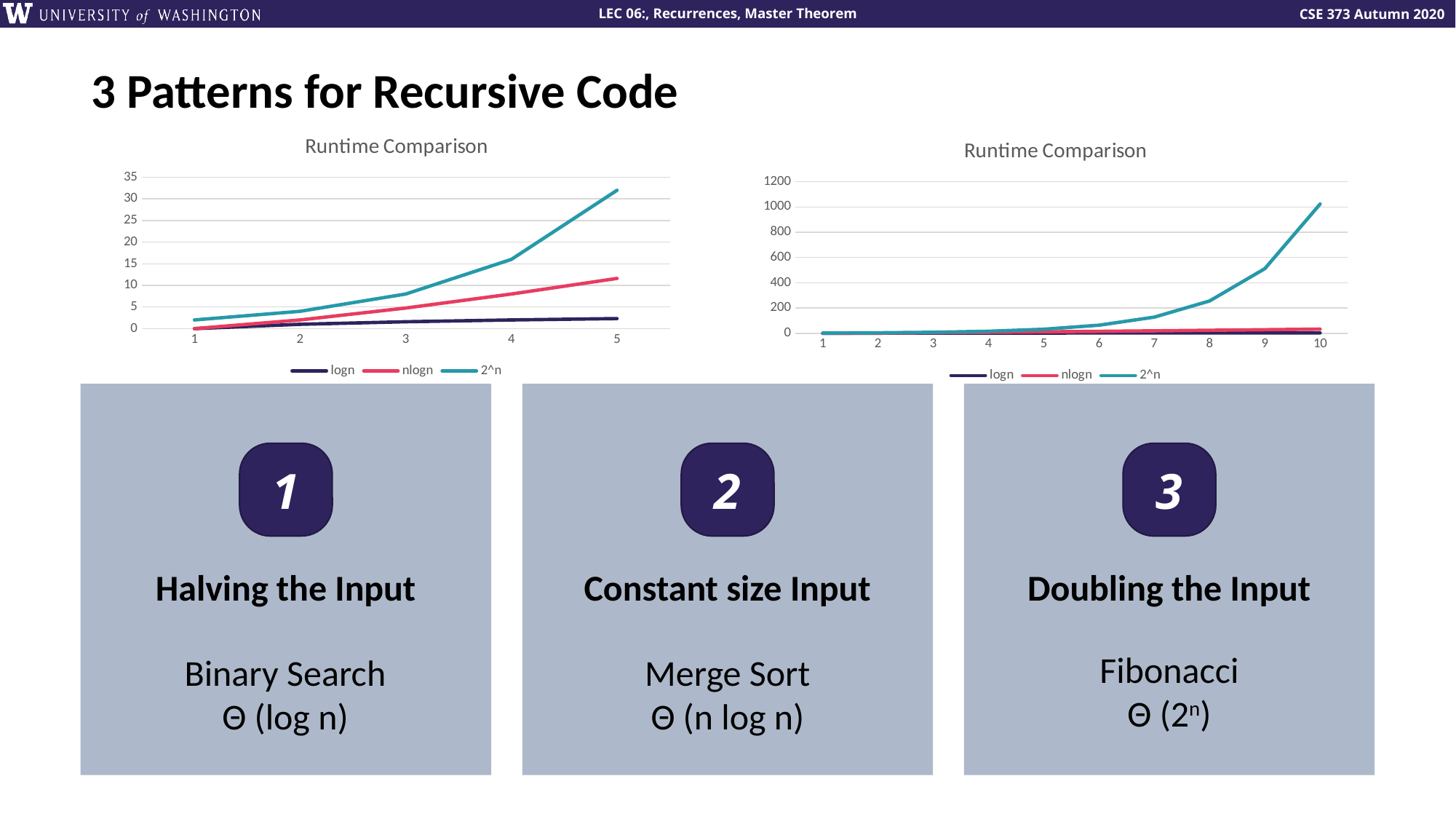
On the right 'Runtime Comparison' chart, does the 2^n series rise or fall as x increases? rise On the left 'Runtime Comparison' chart, which is larger at x = 5: nlogn or logn? nlogn What are the names of the three series in the legend of the right 'Runtime Comparison' chart? logn, nlogn, 2^n On the right 'Runtime Comparison' chart, is the value of 2^n at x = 10 greater or less than 800? greater On the left 'Runtime Comparison' chart, which series has the highest value at x = 5? 2^n On the left 'Runtime Comparison' chart, which series has the lowest value at x = 5? logn On the left 'Runtime Comparison' chart, is the value of 2^n at x = 5 greater or less than 25? greater What type of chart is the left 'Runtime Comparison' chart? line chart On the left 'Runtime Comparison' chart, is the value of nlogn at x = 5 greater or less than 15? less How many series does the legend of the left 'Runtime Comparison' chart list? 3 How many x-axis points are plotted on the left 'Runtime Comparison' chart? 5 How many x-axis points are plotted on the right 'Runtime Comparison' chart? 10